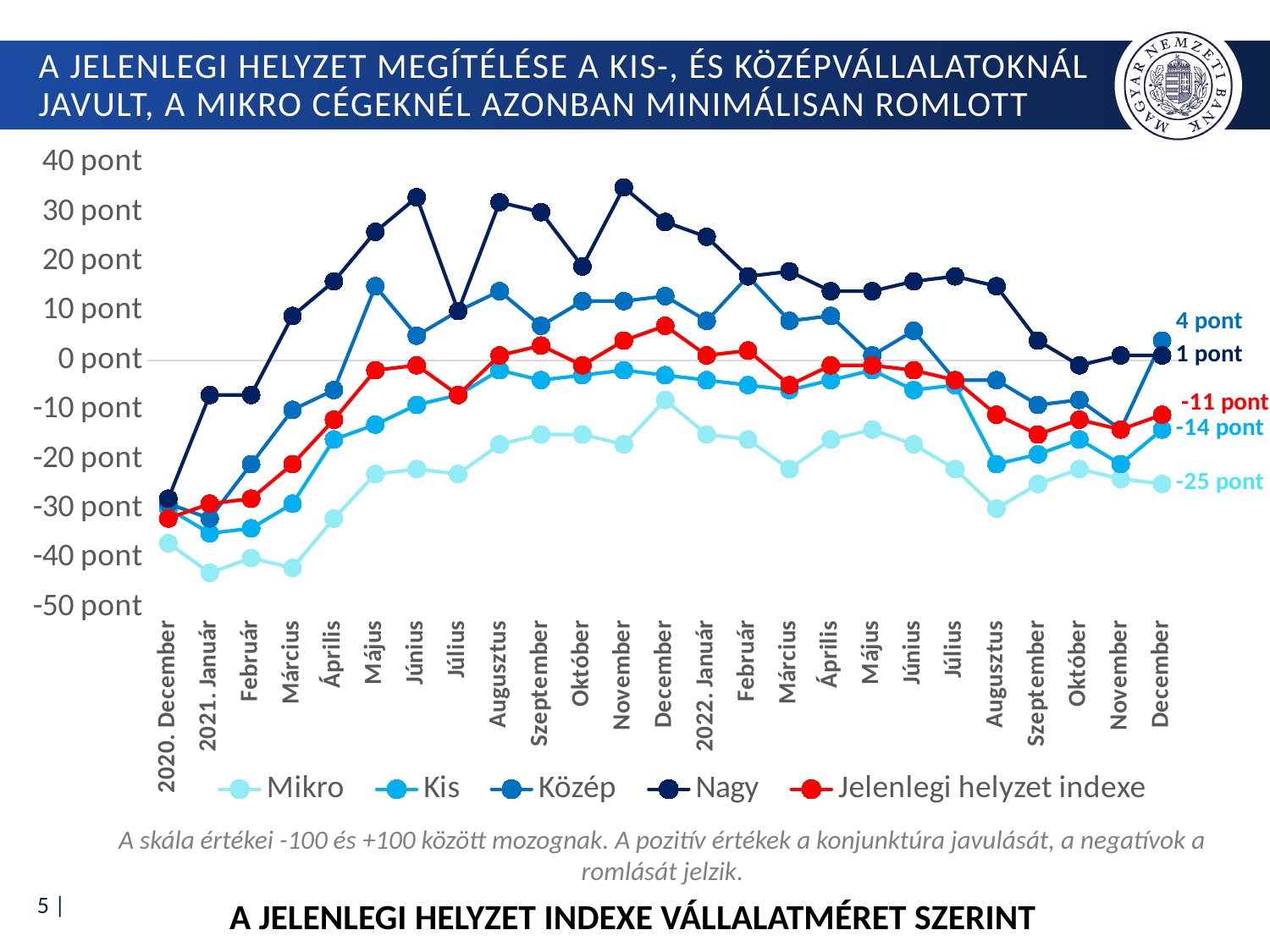
What is the value of the Mikro series in 2022 December? -25 pont How many series does the legend list? 5 What is the value of the Kis series in 2022 December? -14 pont Is the value for the Nagy series in 2021 November greater or less than 30 pont? greater What is the value of the Nagy series in 2022 December? 1 pont What is the value of the Közép series in 2022 December? 4 pont Which series has the lowest value in 2022 December? Mikro What is the value of the Jelenlegi helyzet indexe series in 2022 December? -11 pont What kind of chart is shown on the slide? line chart What is the difference between the Közép and Mikro values in 2022 December? 29 pont Which series has the highest value in 2022 December? Közép In 2022 December, which is larger: the Kis value or the Mikro value? Kis